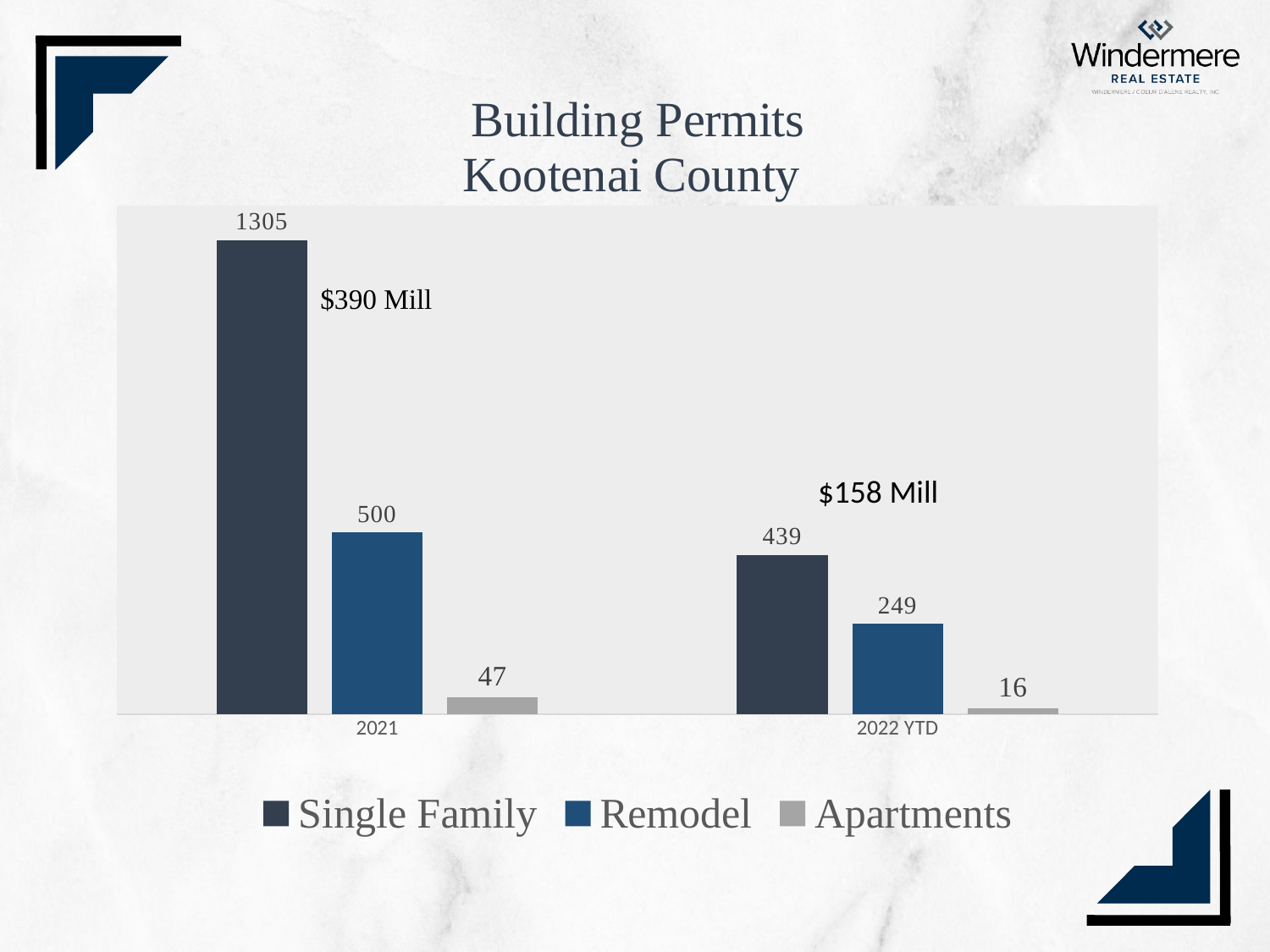
Which series has the lowest value in 2021? Apartments What dollar amount is annotated next to the 2022 YTD bars? $158 Mill Which series has the highest value in 2022 YTD? Single Family What is the difference between the Single Family values for 2021 and 2022 YTD? 866 What is the value for Apartments in 2021? 47 How many categories are shown on the x axis? 2 What is the difference between Remodel and Apartments in 2022 YTD? 233 What kind of chart is shown on the slide? Bar chart Which is larger, Remodel in 2021 or Single Family in 2022 YTD? Remodel in 2021 How many series does the legend list? 3 What is the value for Single Family in 2021? 1305 What is the value for Remodel in 2022 YTD? 249